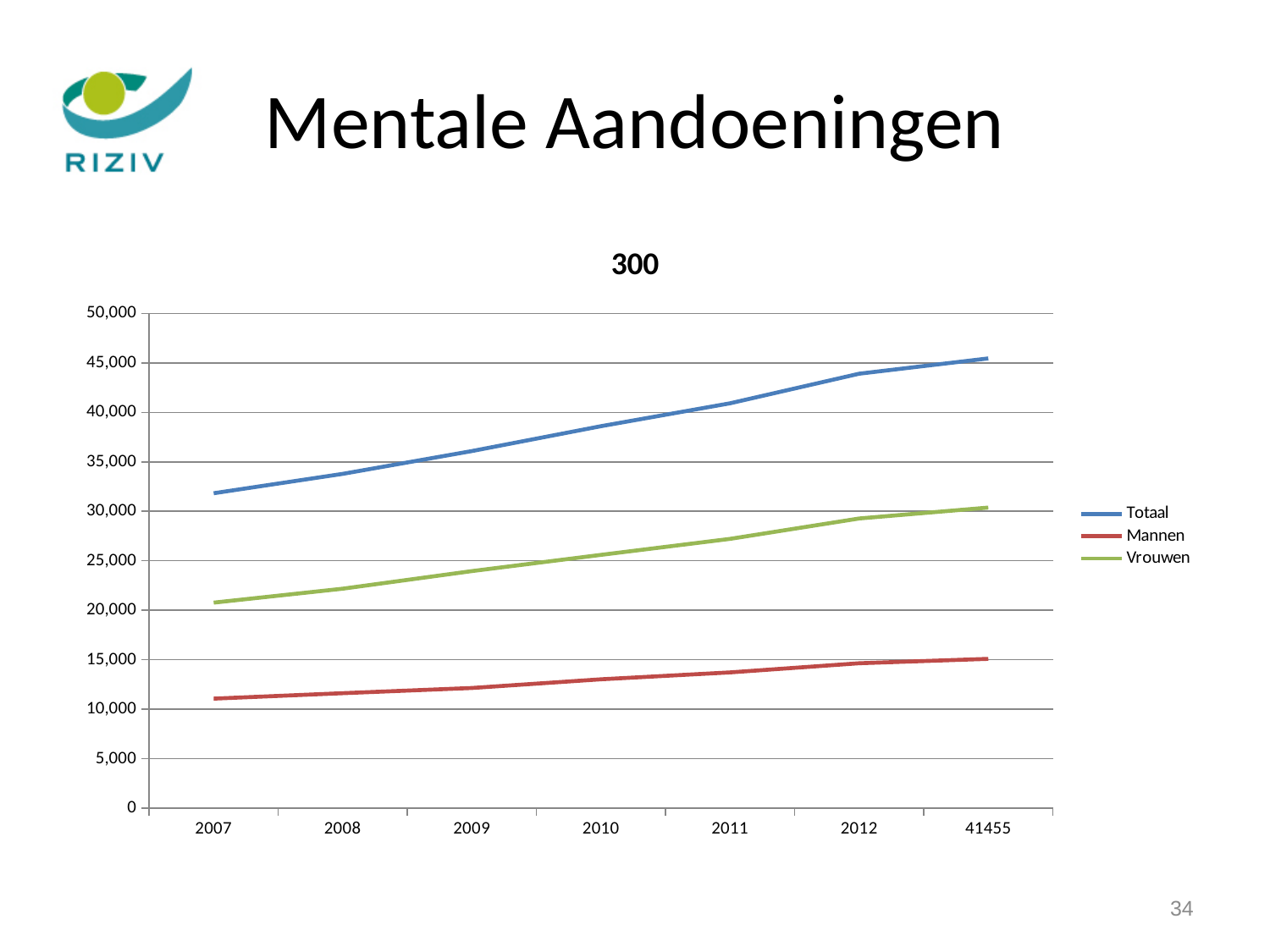
Which series has the lowest values across all years? Mannen In 2009, which is larger: the value for Vrouwen or the value for Mannen? Vrouwen How many points are plotted along the x axis for each series? 7 Which series has the highest values across all years? Totaal What kind of chart is shown on the slide? line chart Is the value for Mannen in 2010 greater or less than 15,000? less How many series does the legend list? 3 Is the value for Vrouwen in 2012 greater or less than 30,000? less Do the values for Totaal rise or fall from 2007 to the last point on the x axis? rise What is the title of the chart? 300 Is the value for Totaal in 2007 greater or less than 30,000? greater Which series is plotted with the blue line? Totaal